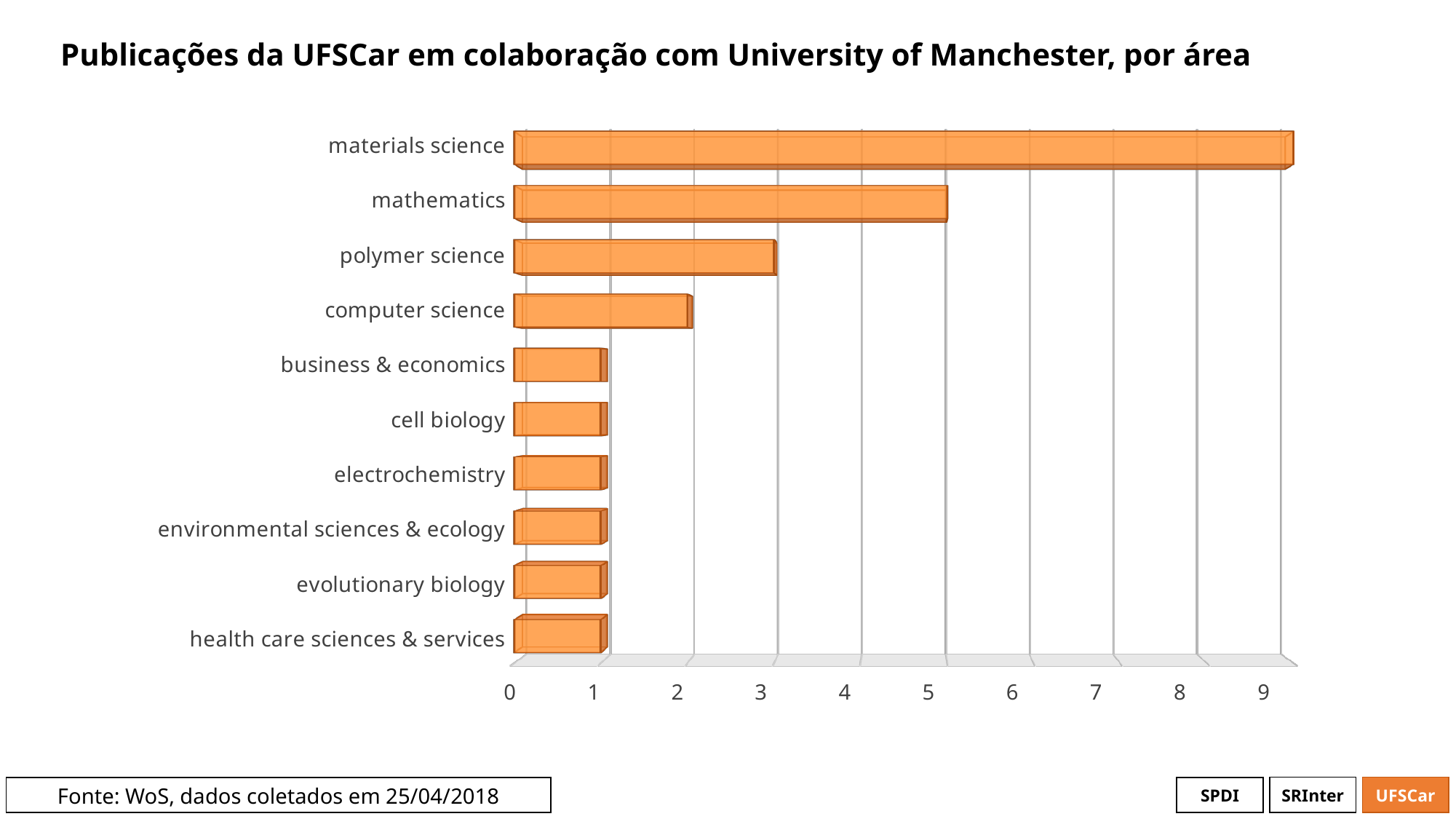
How many publications are shown for computer science? 2 Do the bar values rise or fall going from the top category to the bottom category? fall What is the difference between the values for mathematics and polymer science? 2 What kind of chart is shown on the slide? bar chart Is the value for materials science greater or less than 8? greater How many publications are shown for cell biology? 1 How many publications are shown for mathematics? 5 What is the title of the chart? Publicações da UFSCar em colaboração com University of Manchester, por área How many publications are shown for polymer science? 3 Which area has the highest number of publications? materials science Which has more publications, mathematics or polymer science? mathematics How many areas (categories) are shown in the chart? 10